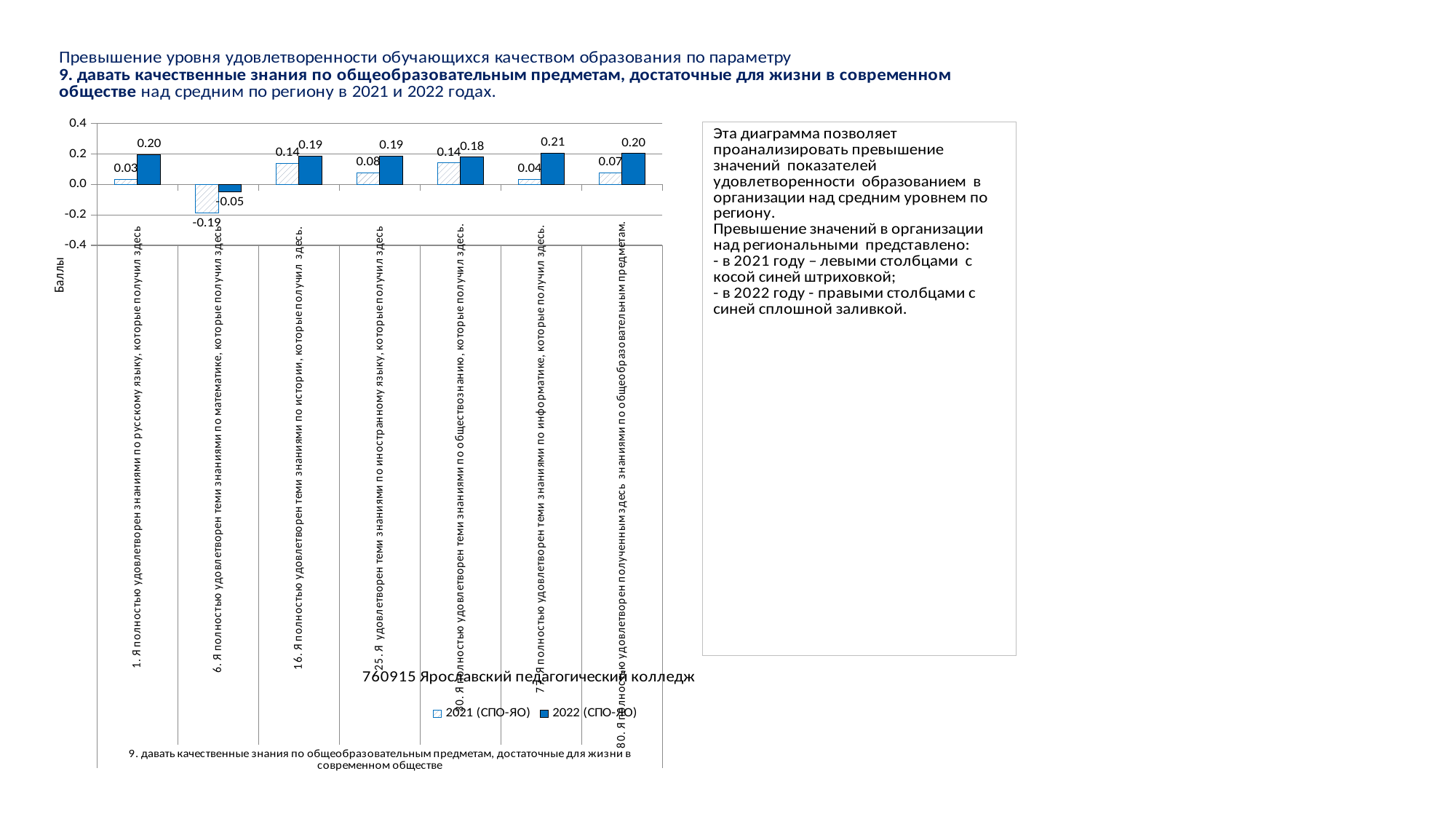
Which category has the lowest 2021 (СПО-ЯО) value? 6. знания по математике (-0.19) How many categories are shown on the x axis of the chart? 7 What are the two entries in the chart legend? 2021 (СПО-ЯО) and 2022 (СПО-ЯО) Is the 2022 value for category 6 (знания по математике) greater or less than 0.0? less What type of chart is shown on the slide? bar chart What is the 2021 (СПО-ЯО) value for category 6 (знания по математике)? -0.19 What is the 2021 (СПО-ЯО) value for category 30 (знания по обществознанию)? 0.14 How many series does the chart legend list? 2 Which is larger: the 2021 value for category 16 (знания по истории) or the 2021 value for category 25 (знания по иностранному языку)? 16. знания по истории Which category has the highest 2022 (СПО-ЯО) value? 77. знания по информатике (0.21) For category 1 (знания по русскому языку), how much higher is the 2022 value than the 2021 value? 0.17 What is the 2022 (СПО-ЯО) value for category 77 (знания по информатике)? 0.21